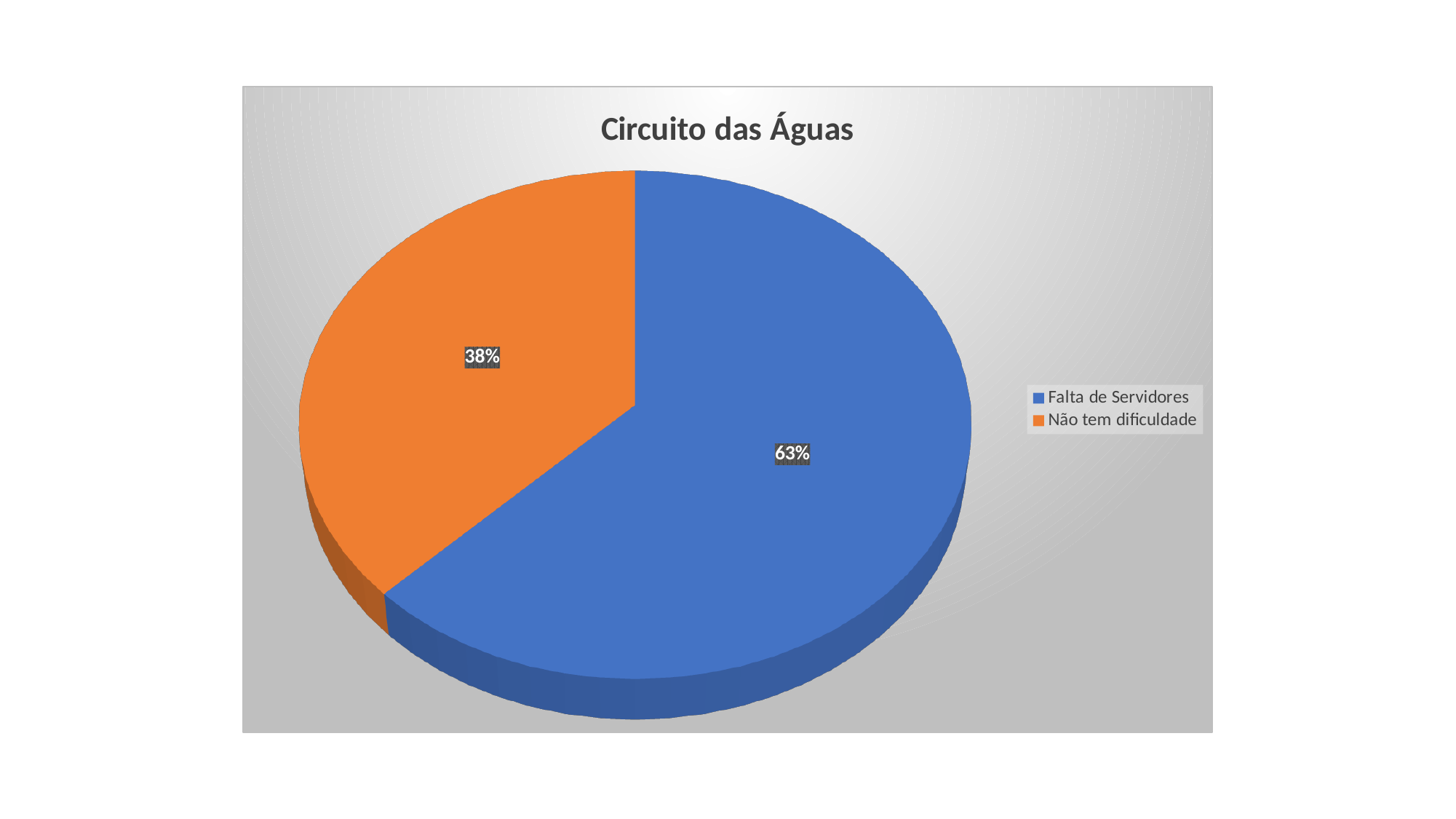
What colour is the slice for "Não tem dificuldade"? orange Which category has the largest slice of the pie? Falta de Servidores Which category has the smallest slice of the pie? Não tem dificuldade What is the difference in percentage points between the "Falta de Servidores" slice and the "Não tem dificuldade" slice? 25% What is the title of the chart? Circuito das Águas How many slices does the pie chart have? 2 Which is larger, the slice for "Falta de Servidores" or the slice for "Não tem dificuldade"? Falta de Servidores How many entries does the legend list? 2 What share of the pie does "Não tem dificuldade" represent? 38% What kind of chart is shown on the slide? pie chart What share of the pie does "Falta de Servidores" represent? 63%